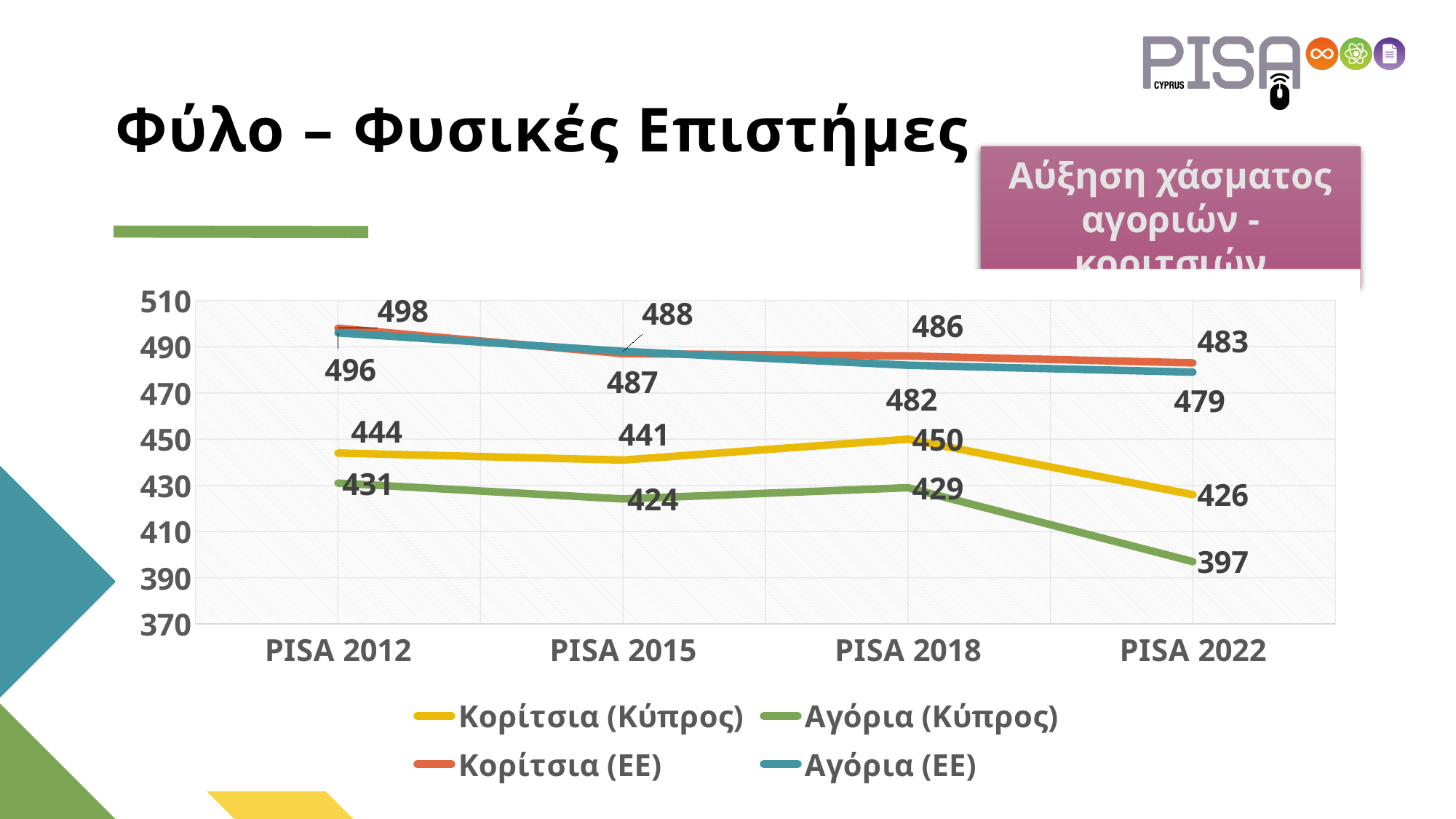
What type of chart is shown on the slide? line chart Does the value for Αγόρια (Κύπρος) rise or fall from PISA 2018 to PISA 2022? fall Which is larger in PISA 2012: Κορίτσια (ΕΕ) or Αγόρια (ΕΕ)? Κορίτσια (ΕΕ) In which PISA cycle is the value for Αγόρια (Κύπρος) lowest? PISA 2022 How many PISA cycles are shown on the x axis? 4 What is the value for Αγόρια (ΕΕ) in PISA 2015? 488 What is the value for Αγόρια (Κύπρος) in PISA 2022? 397 In which PISA cycle is the value for Κορίτσια (Κύπρος) highest? PISA 2018 What is the value for Κορίτσια (Κύπρος) in PISA 2018? 450 What is the difference between Κορίτσια (Κύπρος) and Αγόρια (Κύπρος) in PISA 2022? 29 What is the value for Κορίτσια (ΕΕ) in PISA 2012? 498 How many series does the legend list? 4